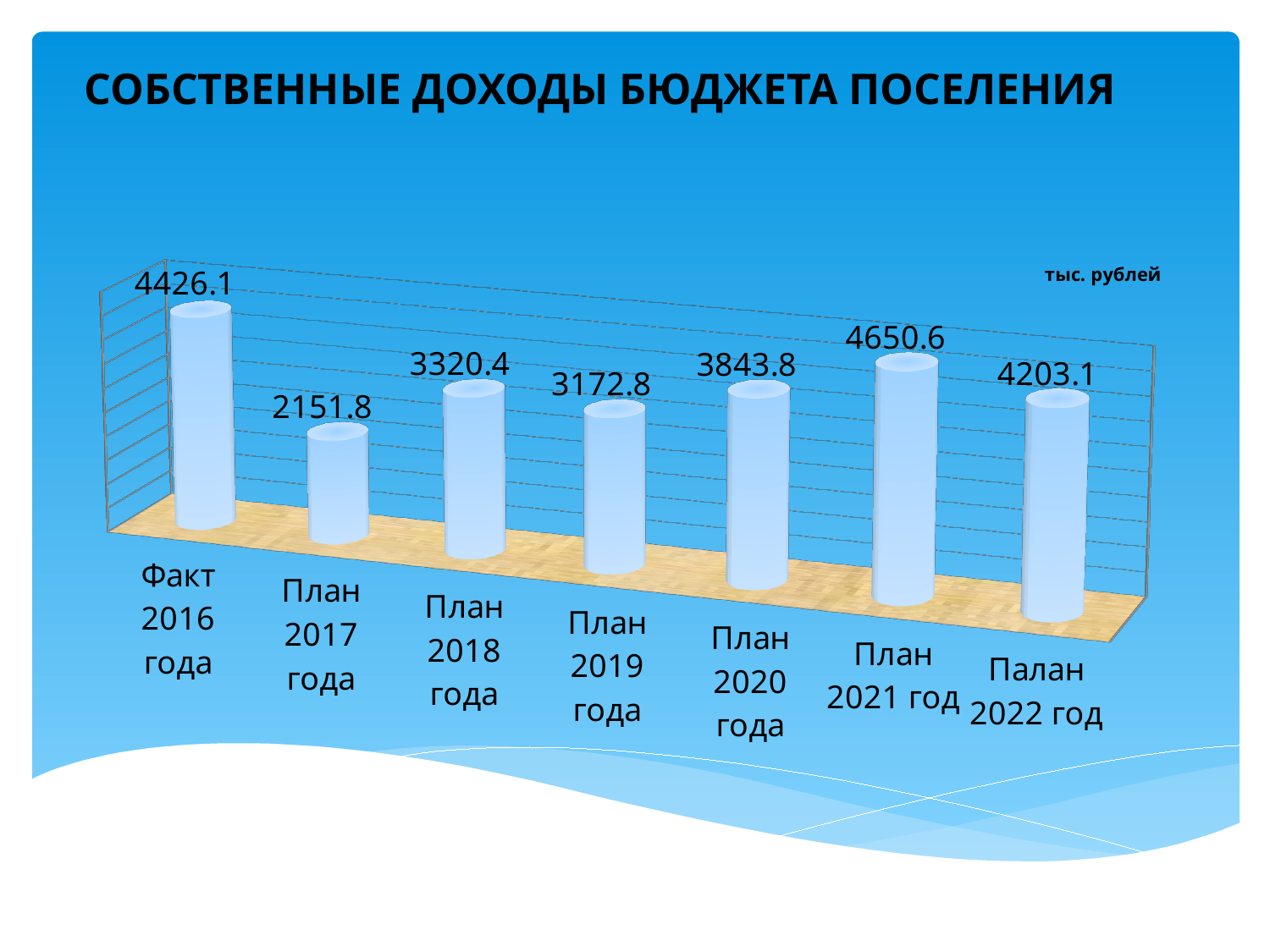
What kind of chart is shown on the slide? Bar chart What is the difference between the values for План 2018 года and План 2019 года? 147.6 Which is larger, the value for План 2018 года or План 2019 года? План 2018 года Which category has the lowest value? План 2017 года Which category has the highest value? План 2021 год What is the value for План 2017 года? 2151.8 What is the difference between the values for План 2021 год and Факт 2016 года? 224.5 What is the value for Факт 2016 года? 4426.1 What is the value for Палан 2022 год? 4203.1 What unit is indicated for the values in the chart? тыс. рублей What is the value for План 2020 года? 3843.8 How many categories are shown in the chart? 7